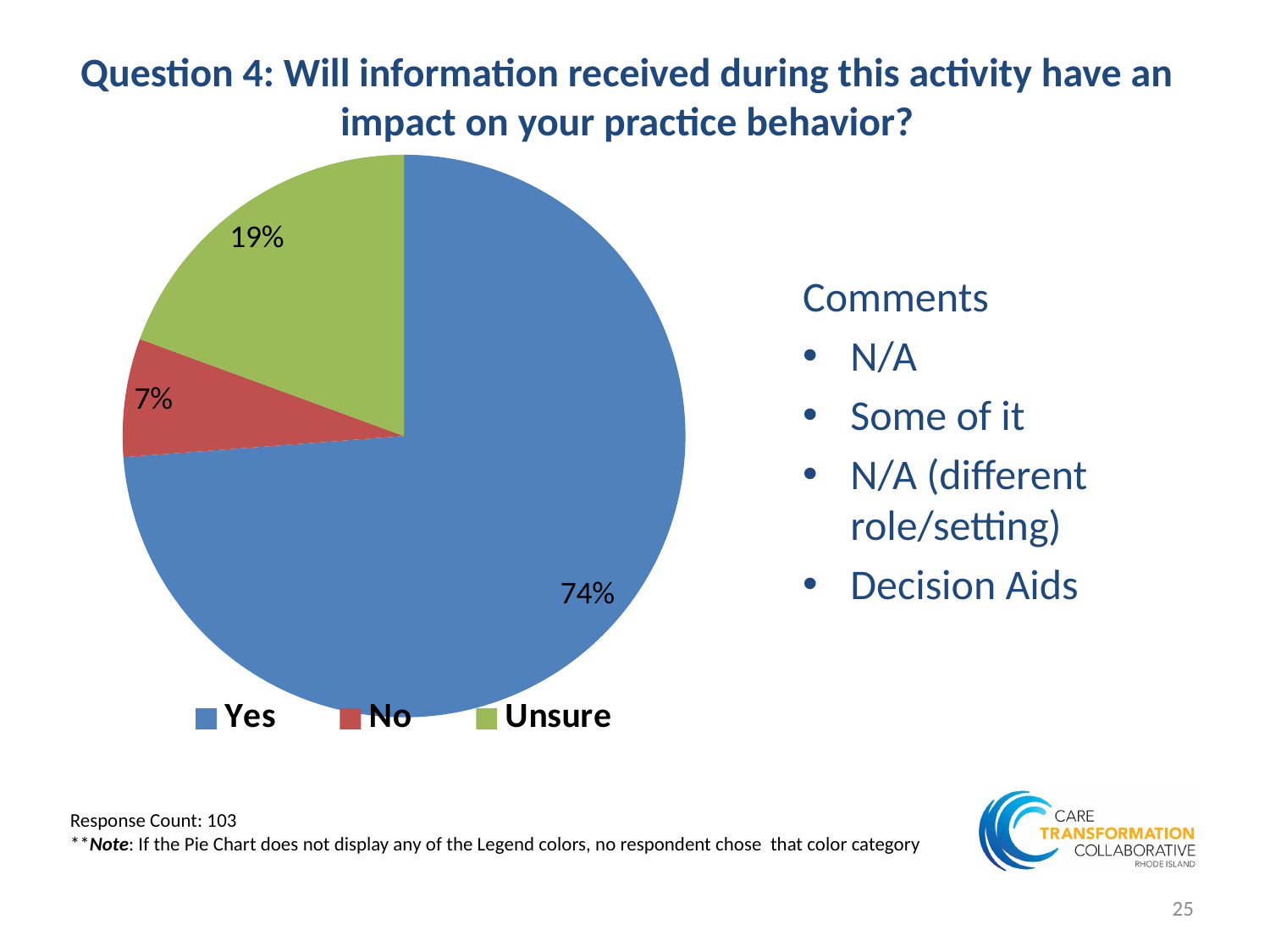
How many categories does the legend list? 3 What percentage of respondents answered No? 7% What is the difference in percentage points between the Yes and Unsure slices? 55 What kind of chart is shown on the slide? pie chart What is the difference in percentage points between the Unsure and No slices? 12 Which response category has the smallest share of the pie? No What percentage of respondents answered Unsure? 19% Which response category has the largest share of the pie? Yes What colour is the Unsure slice of the pie? green Which slice is larger, No or Unsure? Unsure What colour is the Yes slice of the pie? blue What percentage of respondents answered Yes? 74%